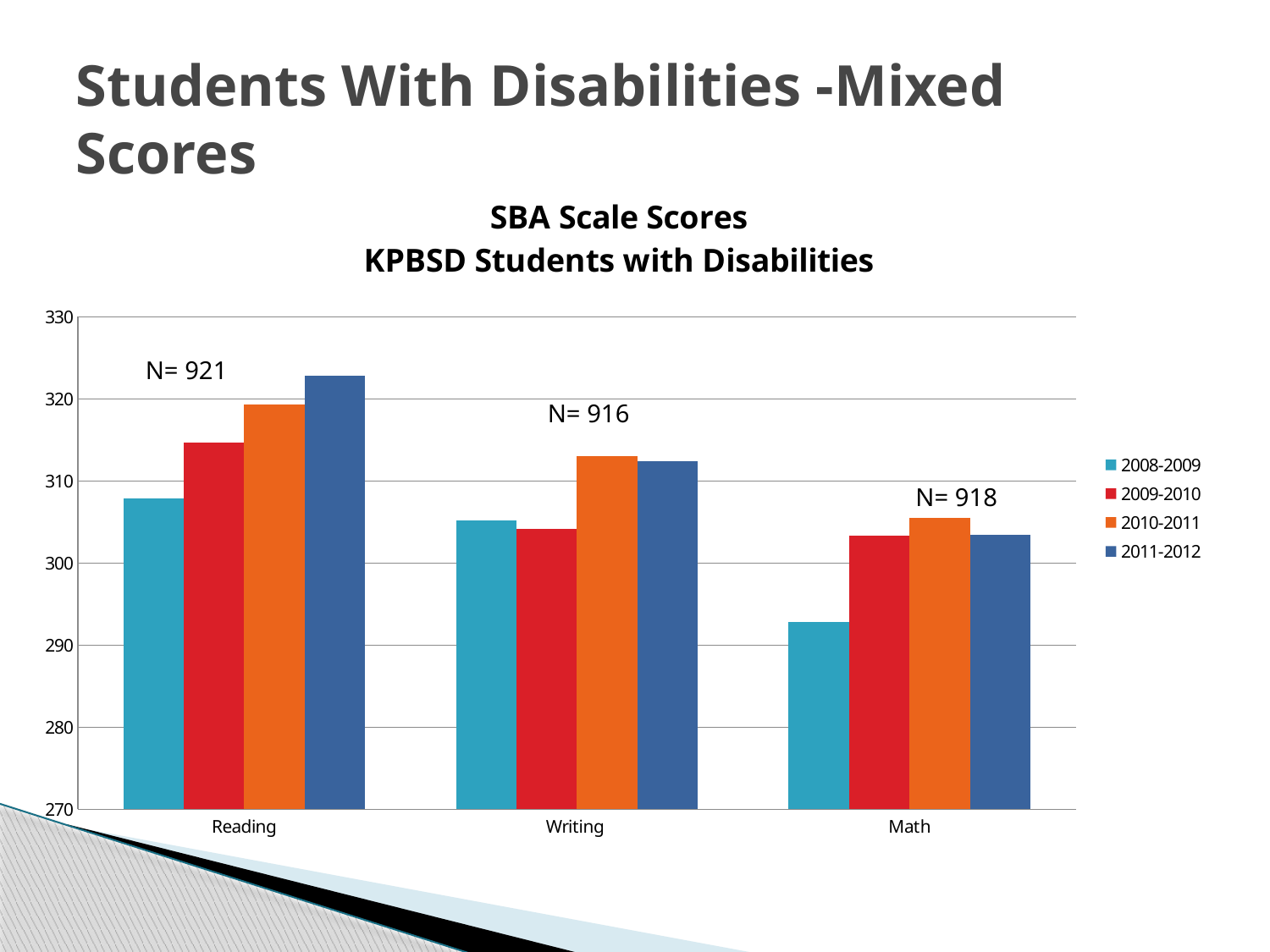
Is the value for Math in 2008-2009 greater or less than 300? less Which is larger: the 2011-2012 score for Reading or the 2011-2012 score for Math? Reading What kind of chart is shown on the slide? bar chart What is the N value shown above the Reading bars? N= 921 Which school year has the lowest score for Math? 2008-2009 Is the value for Reading in 2011-2012 greater or less than 320? greater Do the Reading scores rise or fall from 2008-2009 to 2011-2012? rise How many series does the legend list? 4 What is the N value shown above the Math bars? N= 918 Is the value for Writing in 2010-2011 greater or less than 310? greater Which school year has the highest score for Reading? 2011-2012 How many subject categories are shown on the x axis? 3